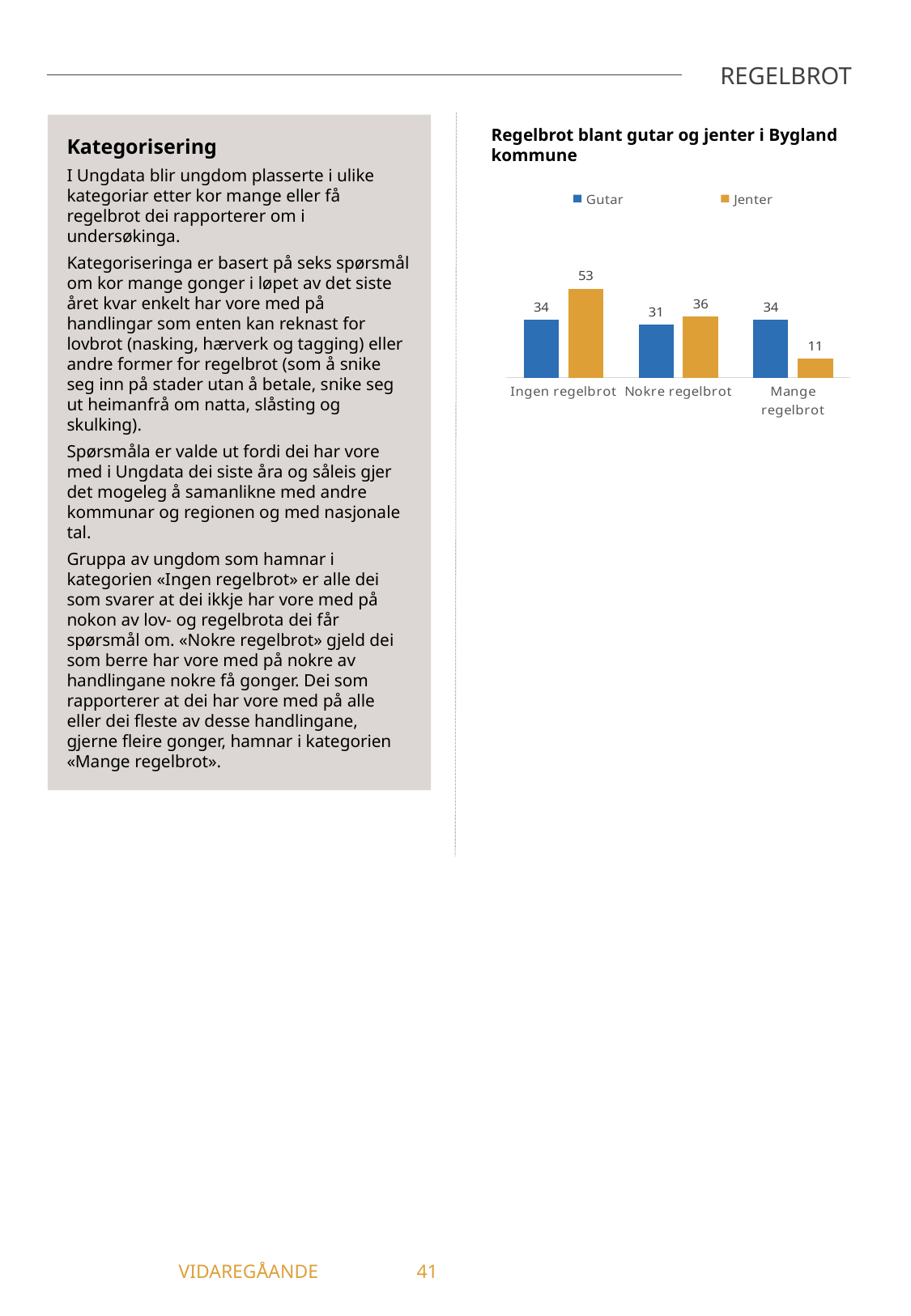
What is the difference between Gutar and Jenter in the Mange regelbrot category? 23 What is the value for Gutar in the Ingen regelbrot category? 34 What is the value for Jenter in the Mange regelbrot category? 11 What is the difference between Jenter and Gutar in the Ingen regelbrot category? 19 Which category has the lowest value for Jenter? Mange regelbrot How many series does the legend list? 2 What is the value for Gutar in the Nokre regelbrot category? 31 In the Nokre regelbrot category, which is larger, Gutar or Jenter? Jenter What is the value for Jenter in the Ingen regelbrot category? 53 What kind of chart is shown on the slide? Bar chart How many categories are shown on the x axis? 3 Which category has the highest value for Jenter? Ingen regelbrot